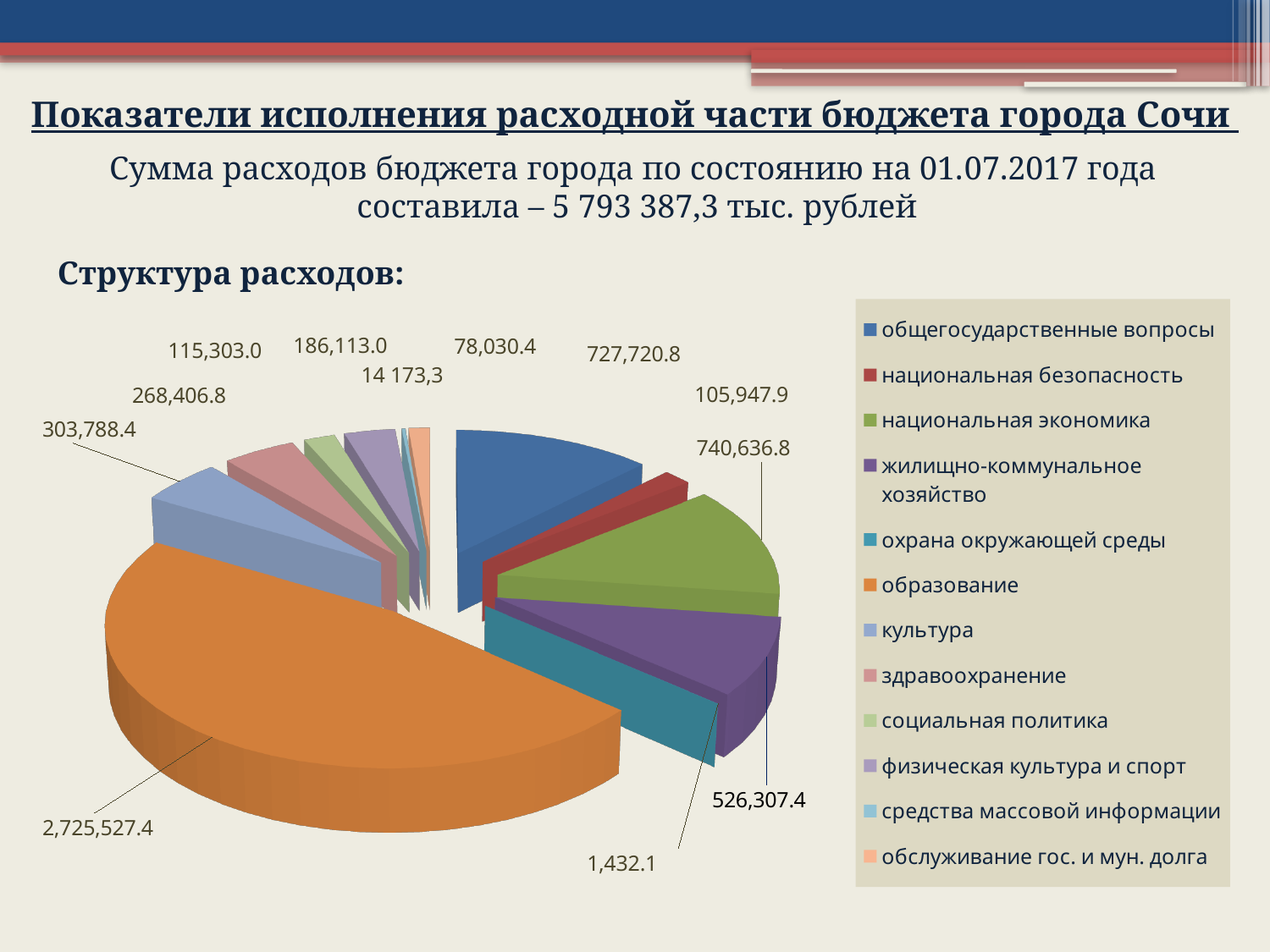
What is the value shown for жилищно-коммунальное хозяйство? 526,307.4 What colour represents образование in the pie chart? orange Which category has the smallest value in the pie chart? охрана окружающей среды Which category has the largest slice in the pie chart? образование What is the value shown for общегосударственные вопросы? 727,720.8 What kind of chart is shown on the slide? pie chart What is the value shown for национальная экономика? 740,636.8 How many categories does the legend of the pie chart list? 12 What is the value shown for образование? 2,725,527.4 What is the difference between the values for национальная экономика and общегосударственные вопросы? 12,916.0 What is the heading printed above the pie chart? Структура расходов: Which is larger: образование or национальная экономика? образование